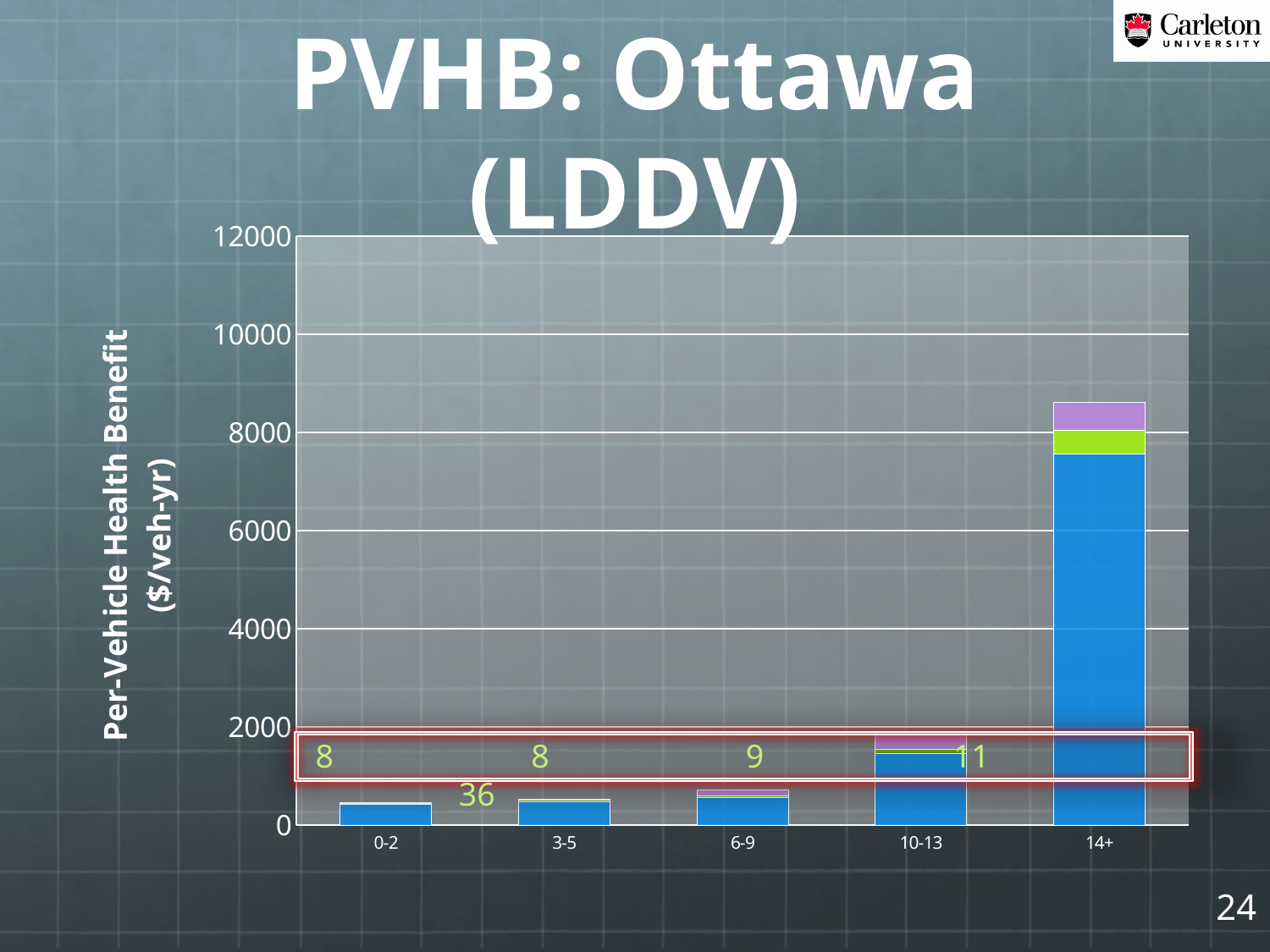
Is the total value for the 0-2 category greater or less than 2000? less What is the title of the chart's vertical axis? Per-Vehicle Health Benefit ($/veh-yr) Is the total value for the 10-13 category greater or less than 2000? less Is the total value for the 6-9 category greater or less than 1000? less Which category has the highest per-vehicle health benefit? 14+ Which has the larger total value, the 14+ category or the 10-13 category? 14+ Do the bar totals generally rise or fall from the 0-2 category to the 14+ category? rise Which has the larger total value, the 10-13 category or the 6-9 category? 10-13 What kind of chart is shown on the slide? stacked bar chart How many vehicle age categories are shown on the x axis? 5 What is the title of the slide? PVHB: Ottawa (LDDV)